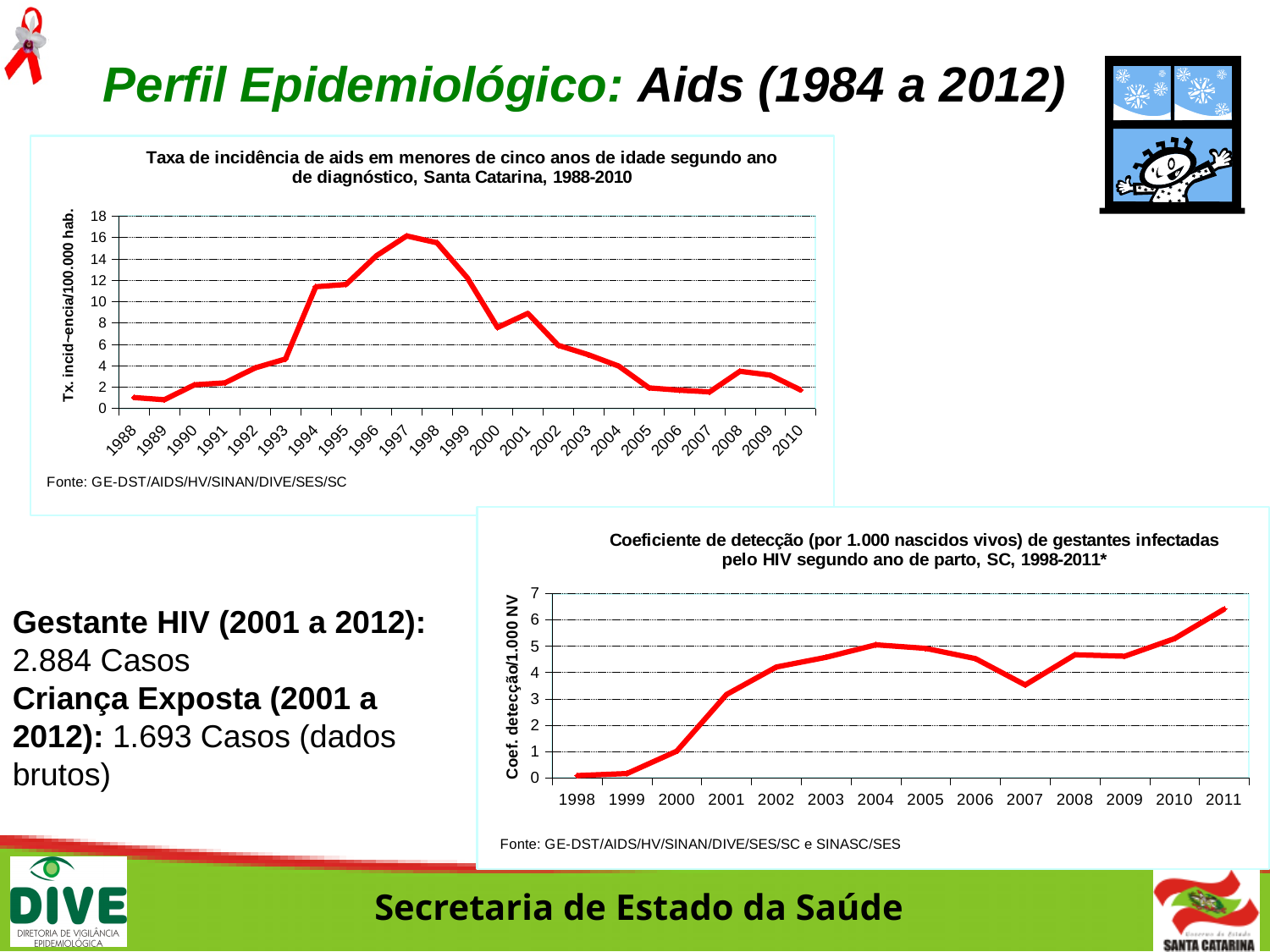
In the top chart (Taxa de incidência de aids em menores de cinco anos), which year has the larger value, 1997 or 2001? 1997 How many years are plotted on the x axis of the bottom chart (Coeficiente de detecção de gestantes infectadas pelo HIV)? 14 How many years are plotted on the x axis of the top chart (Taxa de incidência de aids em menores de cinco anos)? 23 In the bottom chart (Coeficiente de detecção de gestantes infectadas pelo HIV), which year has the highest coefficient? 2011 In the top chart (Taxa de incidência de aids em menores de cinco anos), which year has the highest incidence rate? 1997 In the bottom chart (Coeficiente de detecção de gestantes infectadas pelo HIV), is the value for 2011 greater or less than 6? greater In the bottom chart (Coeficiente de detecção de gestantes infectadas pelo HIV), do the values rise or fall from 1998 to 2004? rise What kind of chart is the top chart titled "Taxa de incidência de aids em menores de cinco anos de idade"? line chart In the top chart (Taxa de incidência de aids em menores de cinco anos), do the values generally rise or fall from 1997 to 2010? fall In the top chart (Taxa de incidência de aids em menores de cinco anos), is the value for 2010 greater or less than 4? less In the top chart (Taxa de incidência de aids em menores de cinco anos), is the value for 1997 greater or less than 14? greater